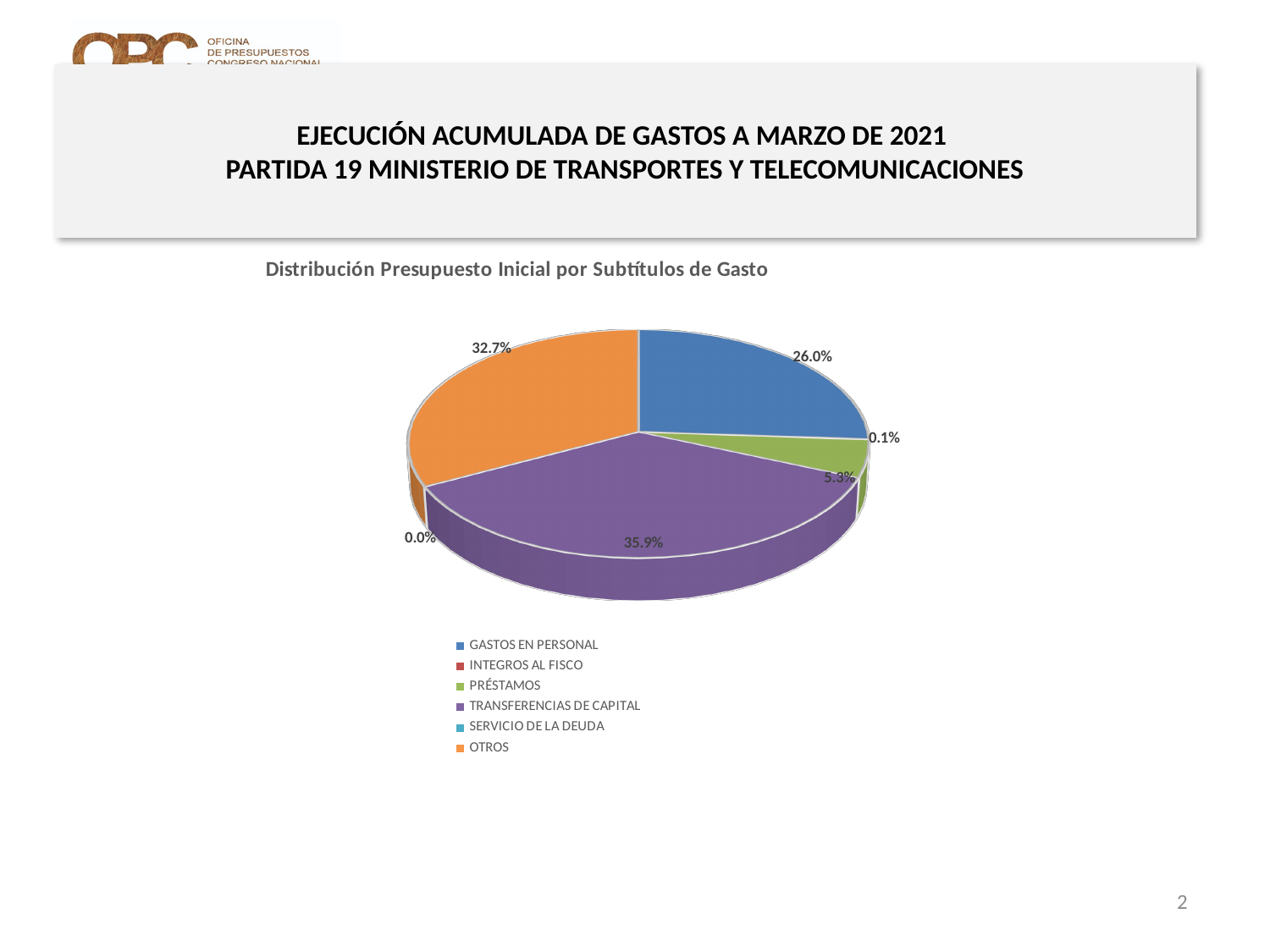
What is the difference between the shares of TRANSFERENCIAS DE CAPITAL and OTROS? 3.2% What share of the pie does TRANSFERENCIAS DE CAPITAL represent? 35.9% What is the value shown for INTEGROS AL FISCO? 0.1% How many categories does the legend list? 6 Which category has the largest share of the pie? TRANSFERENCIAS DE CAPITAL What is the value shown for PRÉSTAMOS? 5.3% Which is larger, the share for GASTOS EN PERSONAL or the share for OTROS? OTROS Which category has the smallest share of the pie? SERVICIO DE LA DEUDA What is the title of the chart? Distribución Presupuesto Inicial por Subtítulos de Gasto What is the value shown for GASTOS EN PERSONAL? 26.0% What type of chart is shown on the slide? Pie chart What is the value shown for OTROS? 32.7%